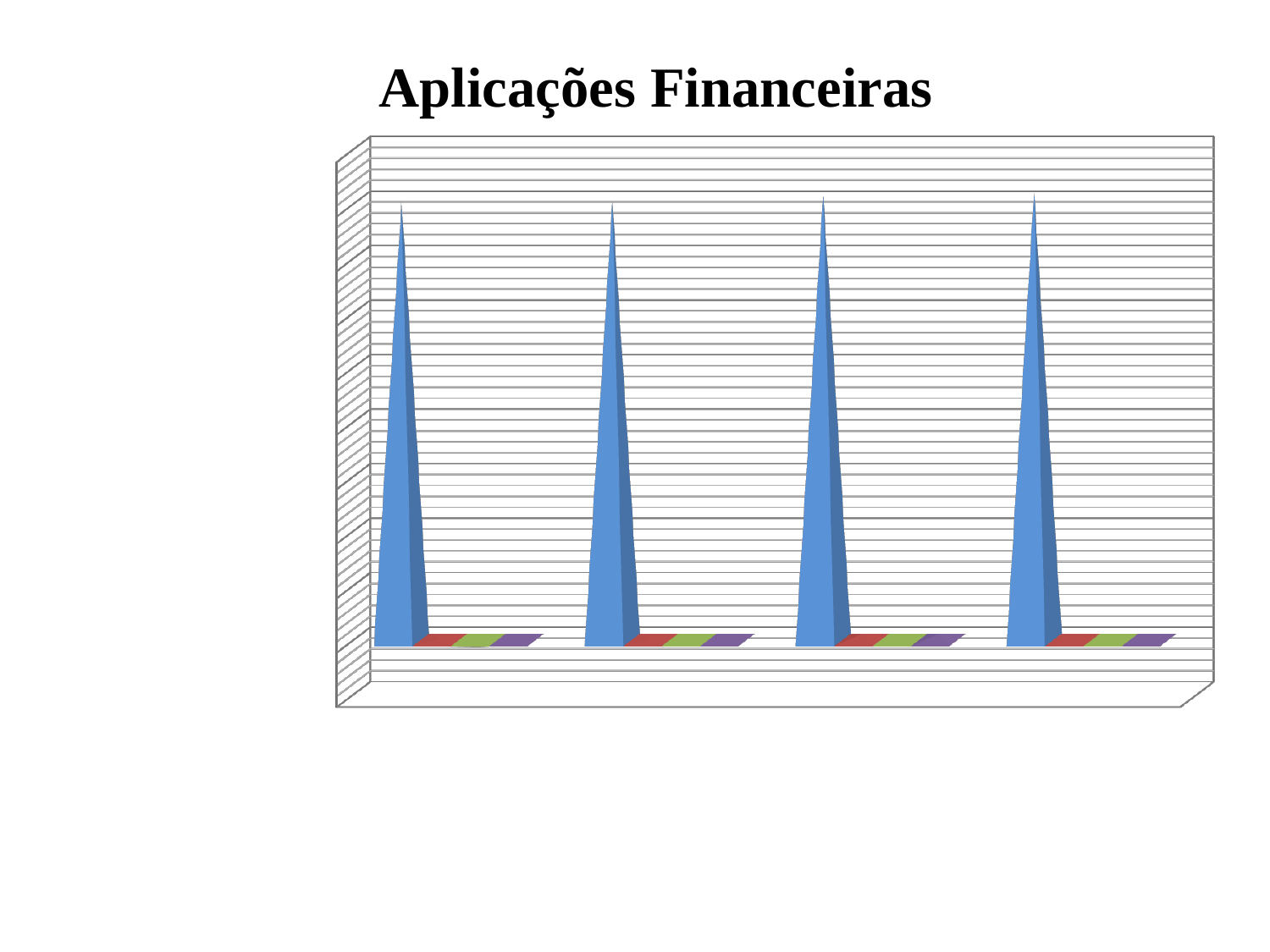
Which coloured series has the tallest bars in every group? blue What kind of chart is shown on the slide? bar chart What is the title of the chart? Aplicações Financeiras In the first group, is the blue bar taller or shorter than the red bar? taller How many groups of bars are plotted in the chart? 4 How many different bar colours appear in each group? 4